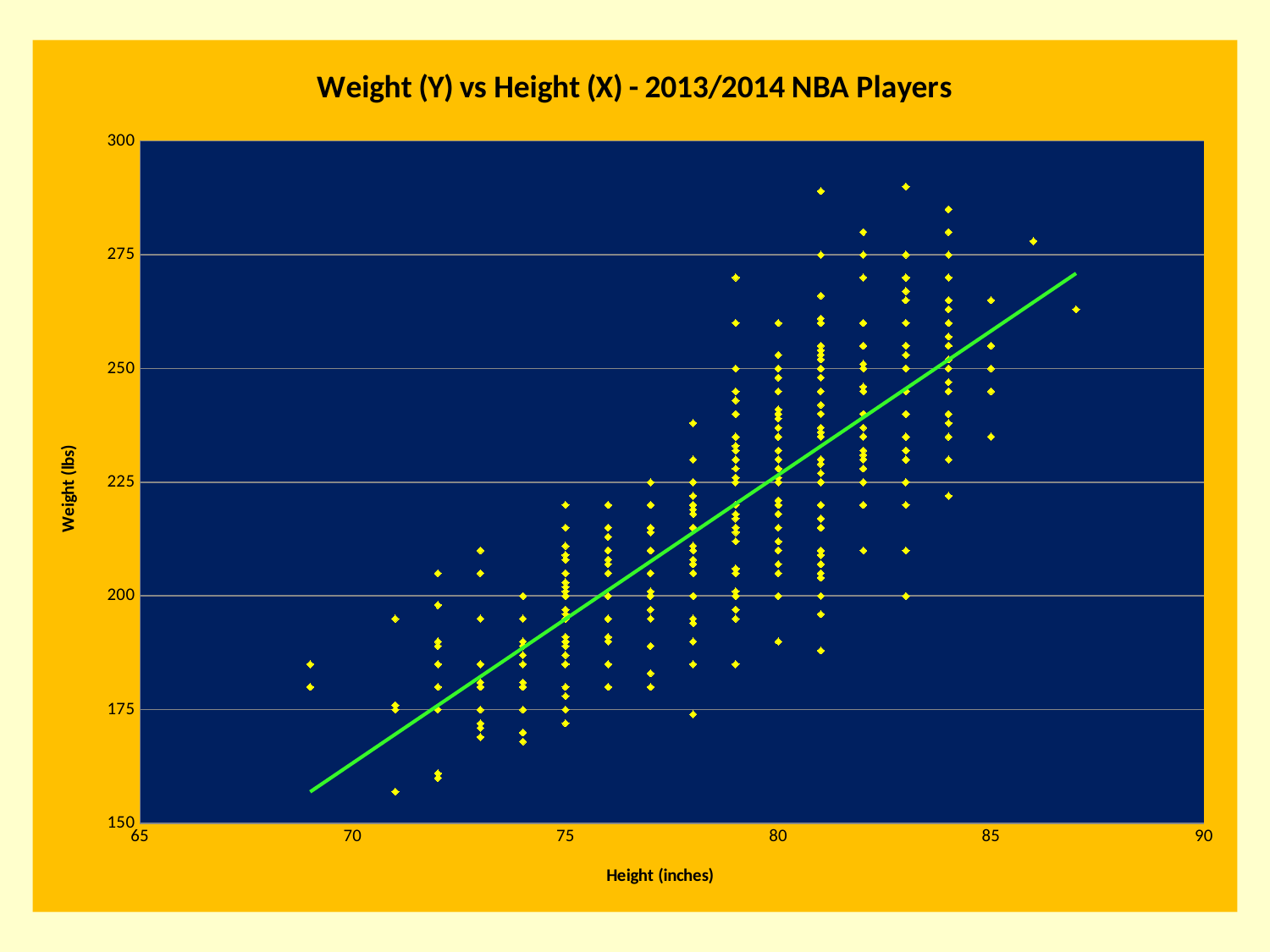
Is the trend line's value at a height of 85 inches greater or less than 250? greater Does the green trend line slope upward or downward from left to right? upward Is the lightest plotted weight greater or less than 175? less What label is shown on the x axis of the chart? Height (inches) Is the trend line's value at a height of 80 inches greater or less than 250? less What is the title of the chart? Weight (Y) vs Height (X) - 2013/2014 NBA Players As height increases along the x axis, does weight generally rise or fall? rise What kind of chart is shown on the slide? scatter plot